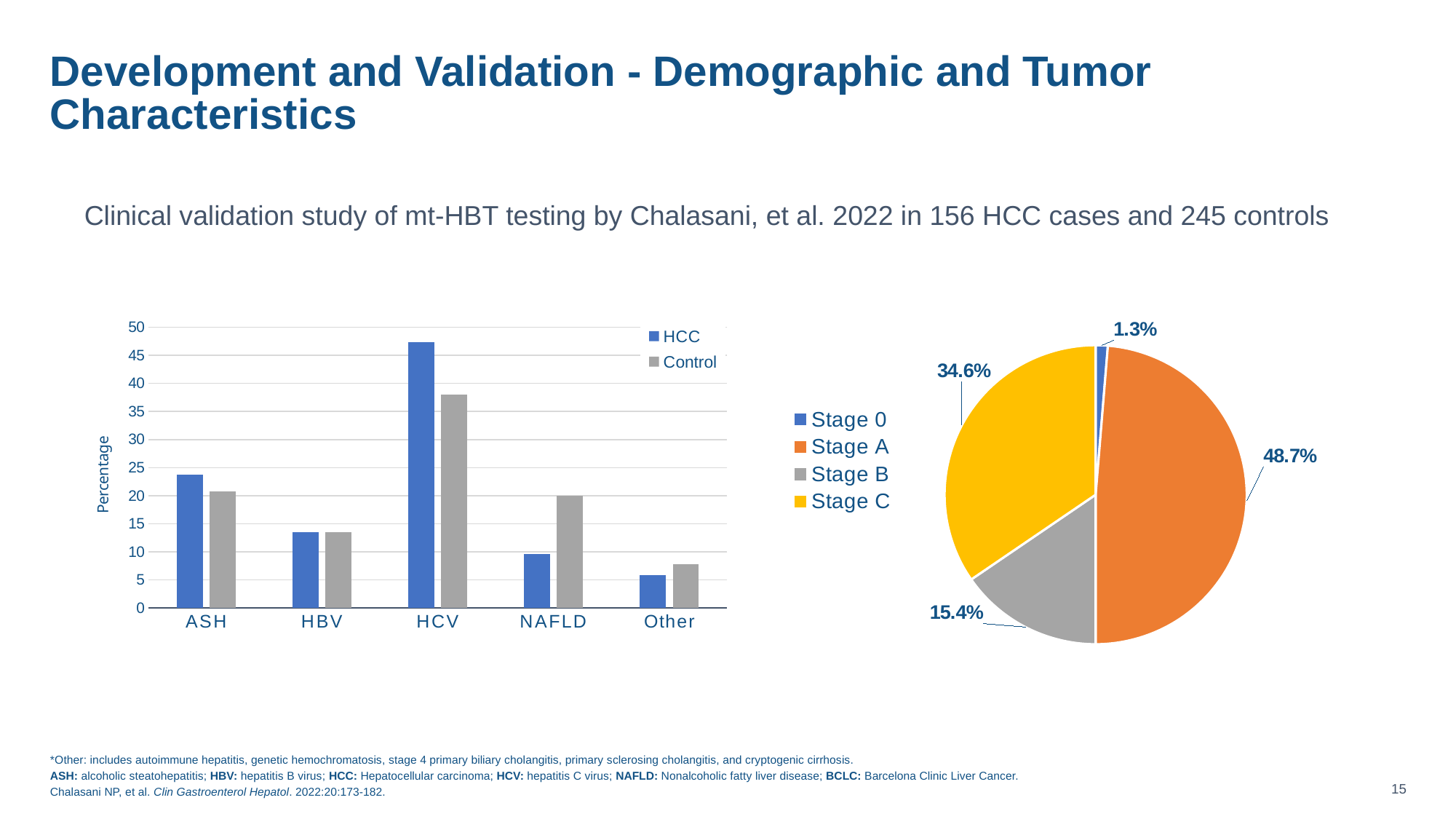
On the right pie chart, what percentage is shown for Stage A? 48.7% On the left bar chart, which category has the lowest HCC value? Other On the right pie chart, how many slices are there? 4 On the left bar chart, which is larger for NAFLD, the HCC value or the Control value? Control On the left bar chart, is the HCC value for HCV greater or less than 45? greater On the right pie chart, which stage has the smallest share? Stage 0 On the left bar chart, how many categories are shown on the x axis? 5 On the left bar chart, how many series does the legend list? 2 What kind of chart is the chart on the left of the slide? bar chart On the left bar chart, which category has the highest HCC value? HCV On the right pie chart, what is the difference between the Stage C and Stage B percentages? 19.2% On the left bar chart, is the Control value for NAFLD greater or less than 15? greater